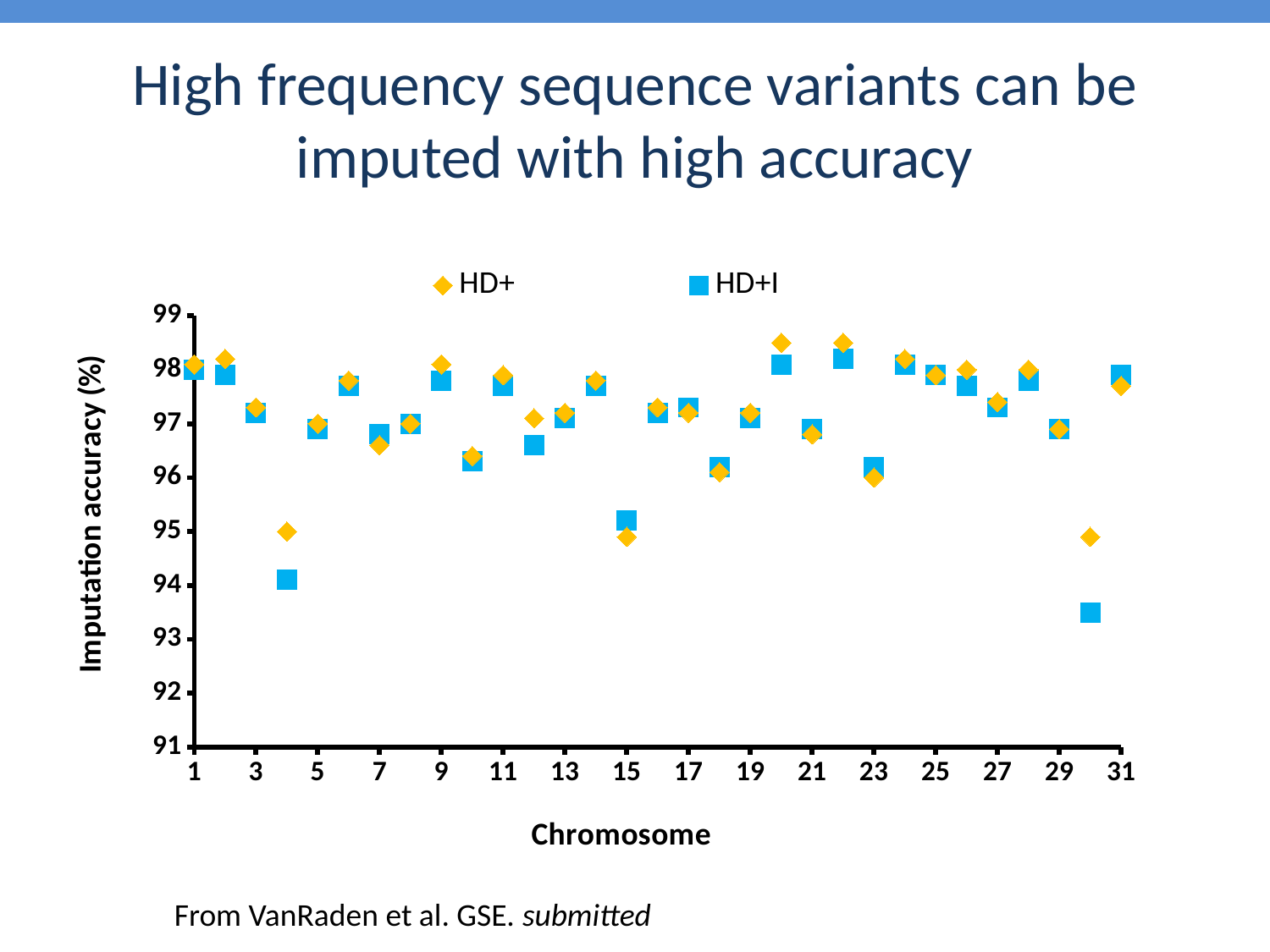
For chromosome 30, which series has the higher imputation accuracy, HD+ or HD+I? HD+ How many chromosomes are plotted along the x axis? 31 Is the HD+ value for chromosome 1 greater or less than 97? greater Is the HD+I value for chromosome 30 greater or less than 94? less Which chromosome has the lowest imputation accuracy for the HD+I series? 30 What kind of chart is shown on the slide? Scatter chart How many series does the legend list? 2 Which series is shown with blue square markers? HD+I Is the HD+I value for chromosome 4 greater or less than 95? less What is the title of the y axis? Imputation accuracy (%) For chromosome 4, which series has the higher imputation accuracy, HD+ or HD+I? HD+